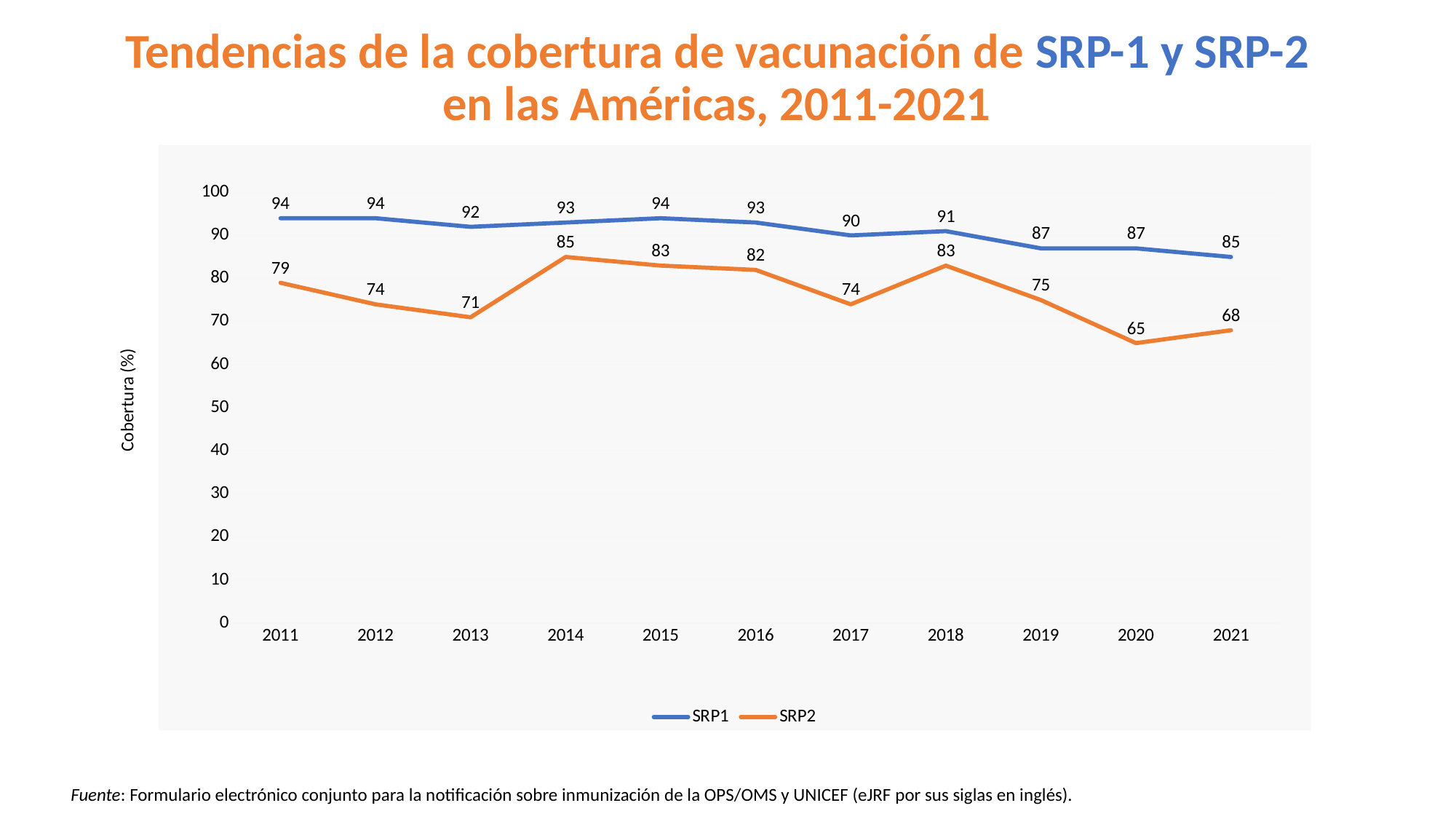
In which year is the SRP2 coverage lowest? 2020 What is the SRP2 coverage value for 2020? 65 Does the SRP1 coverage generally rise or fall from 2015 to 2021? Fall What is the difference between SRP1 and SRP2 coverage in 2021? 17 How many series does the legend list? 2 Which is larger, the SRP2 value for 2014 or the SRP2 value for 2017? 2014 What is the SRP1 coverage value for 2011? 94 In which year is the SRP1 coverage lowest? 2021 How many years are shown on the x axis? 11 What is the SRP2 coverage value for 2014? 85 What is the difference between SRP2 coverage in 2018 and 2020? 18 What kind of chart is shown on the slide? Line chart